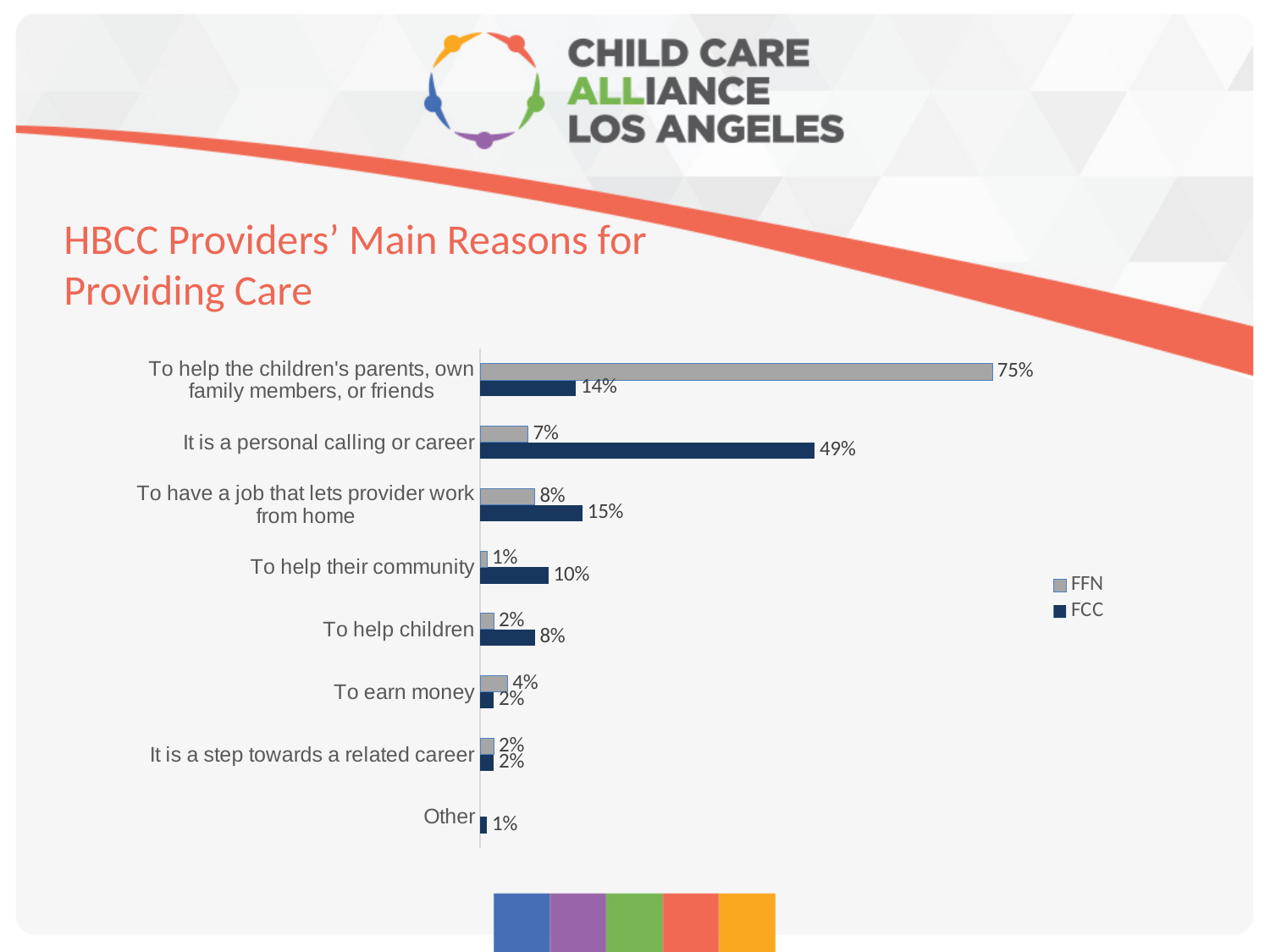
What is the FFN value for 'To help their community'? 1% What percentage of FFN providers cite helping the children's parents, own family members, or friends as their main reason for providing care? 75% Which reason has the highest FCC percentage? It is a personal calling or career For 'To earn money', which series has the larger value, FFN or FCC? FFN How many reasons (categories) are listed on the chart? 8 How many series does the legend list? 2 Which reason has the highest FFN percentage? To help the children's parents, own family members, or friends What type of chart is shown on the slide? Bar chart What is the title of the slide containing the chart? HBCC Providers' Main Reasons for Providing Care What is the FCC value for 'To have a job that lets provider work from home'? 15% What is the difference between the FFN and FCC values for 'To help the children's parents, own family members, or friends'? 61 percentage points What percentage of FCC providers say it is a personal calling or career? 49%